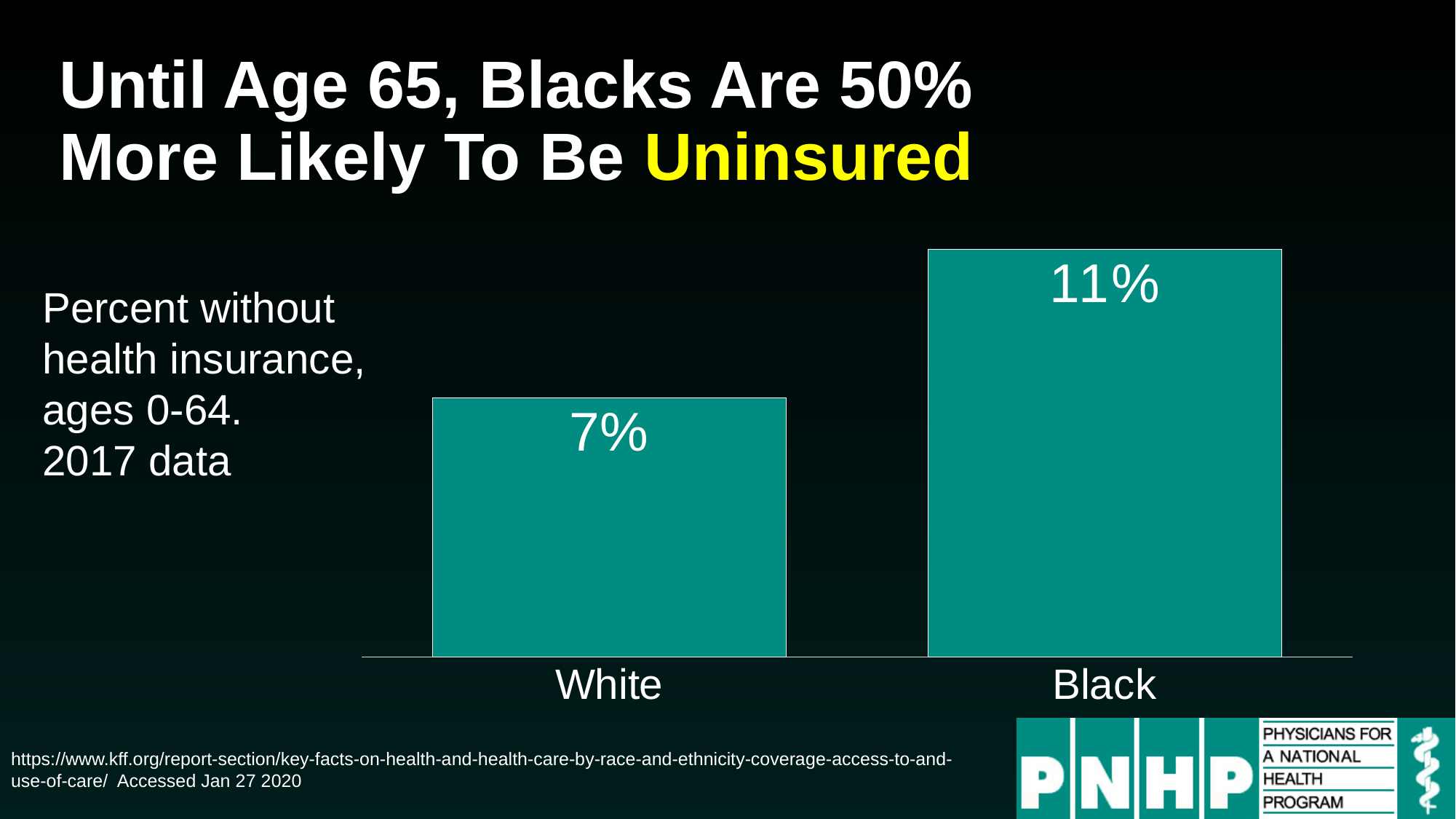
Do the values rise or fall from White to Black? Rise Which category has the highest percent without health insurance? Black What colour are the bars in the chart? Teal What is the percent without health insurance for Black? 11% How many categories are shown on the chart? 2 What is the percent without health insurance for White? 7% What kind of chart is shown on the slide? Bar chart What year's data does the chart show, according to the text on the slide? 2017 Which category has the lowest percent without health insurance? White What is the difference in percentage points between the Black and White bars? 4 Which is larger, the value for White or the value for Black? Black